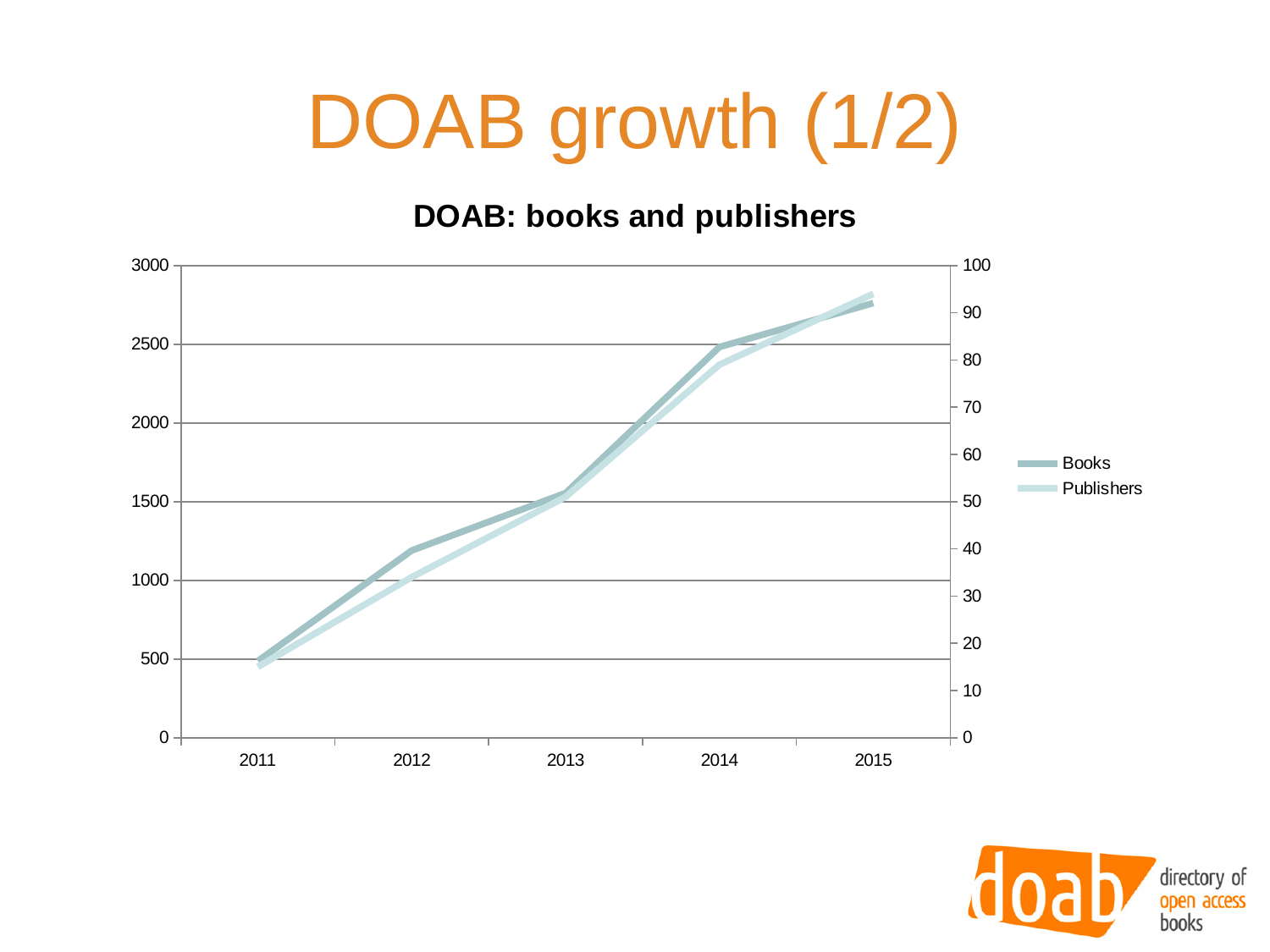
Is the Books value for 2012 greater or less than 1000? greater What is the title of the chart? DOAB: books and publishers Which two series are listed in the legend? Books and Publishers How many series does the legend list? 2 What kind of chart is shown on the slide? Line chart In which year is the Books series at its highest? 2015 Do the Books values rise or fall from 2011 to 2015? Rise In which year is the Publishers series at its lowest? 2011 Is the Publishers value for 2011 greater or less than 20? less Is the Publishers value for 2014 greater or less than 70? greater How many years are plotted along the x axis? 5